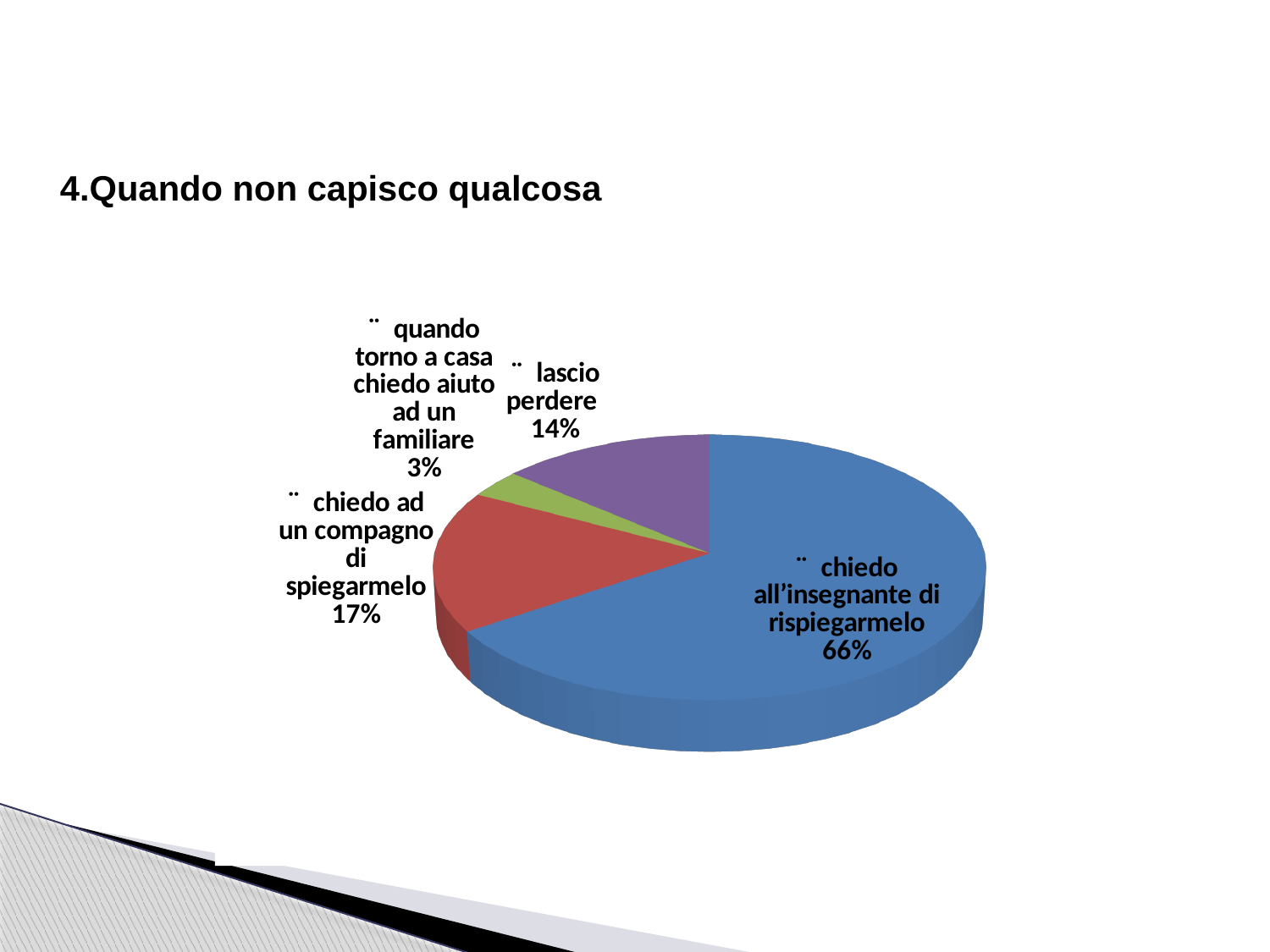
What is the title of the slide above the pie chart? 4.Quando non capisco qualcosa How many slices does the pie chart have? 4 What percentage of the pie is 'quando torno a casa chiedo aiuto ad un familiare'? 3% What kind of chart is shown on the slide? Pie chart Which is larger: 'chiedo ad un compagno di spiegarmelo' or 'lascio perdere'? chiedo ad un compagno di spiegarmelo What is the difference in percentage points between 'chiedo all'insegnante di rispiegarmelo' and 'chiedo ad un compagno di spiegarmelo'? 49 What percentage of the pie is 'chiedo all'insegnante di rispiegarmelo'? 66% What percentage of the pie is 'chiedo ad un compagno di spiegarmelo'? 17% What percentage of the pie is 'lascio perdere'? 14% Which slice of the pie is the largest? chiedo all'insegnante di rispiegarmelo What is the difference in percentage points between 'lascio perdere' and 'quando torno a casa chiedo aiuto ad un familiare'? 11 Which slice of the pie is the smallest? quando torno a casa chiedo aiuto ad un familiare